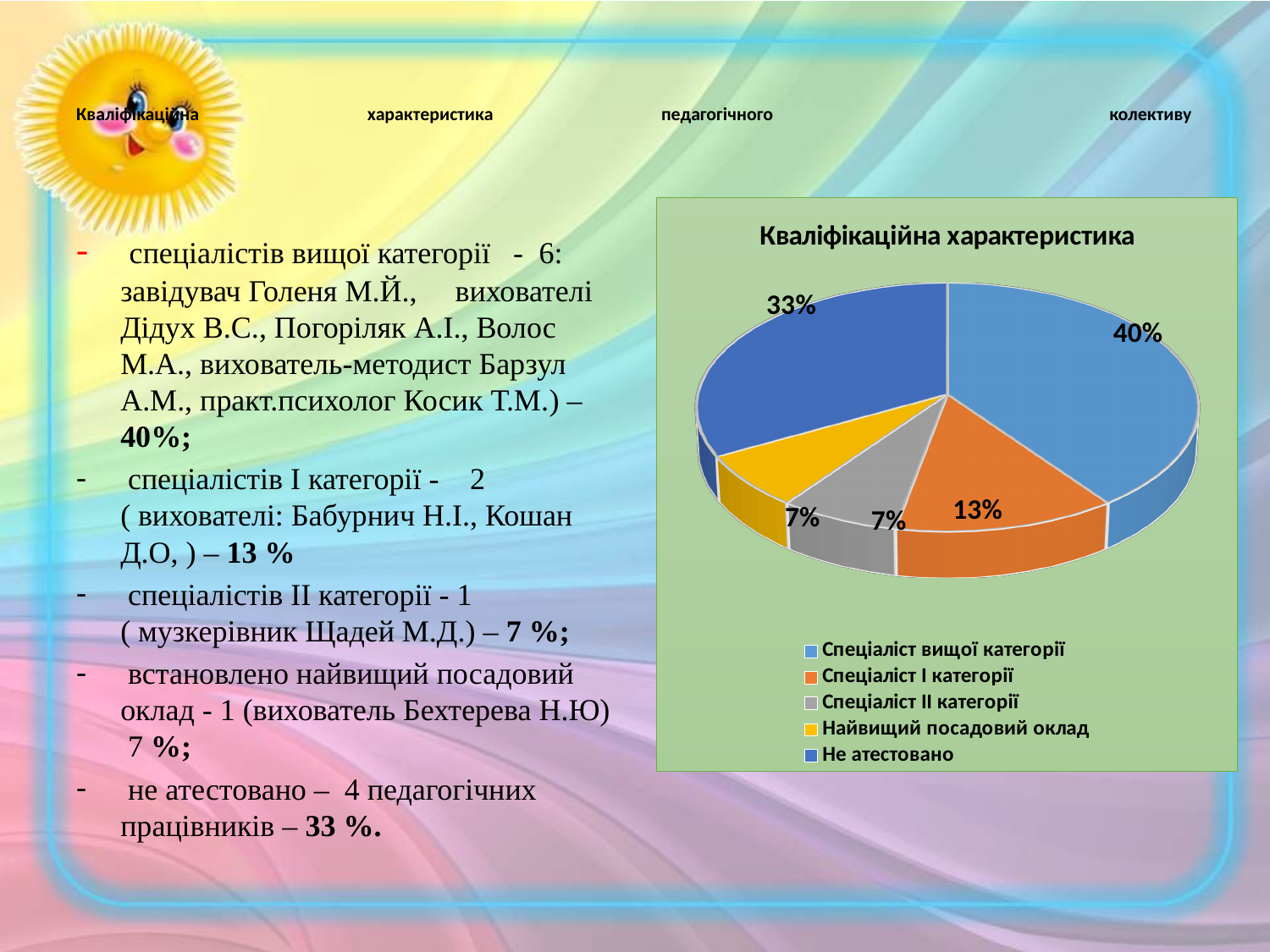
How many slices does the pie chart have? 5 What colour is the slice for Спеціаліст I категорії? orange What is the difference in percentage points between the Спеціаліст вищої категорії slice and the Не атестовано slice? 7 What share of the pie is labelled for Спеціаліст I категорії? 13% What share of the pie is labelled for Не атестовано? 33% Which slice is larger: Спеціаліст I категорії or Найвищий посадовий оклад? Спеціаліст I категорії What share of the pie is labelled for Спеціаліст II категорії? 7% What type of chart is shown on the slide? pie chart What is the title of the chart? Кваліфікаційна характеристика How many entries does the chart legend list? 5 Which category has the largest slice of the pie? Спеціаліст вищої категорії